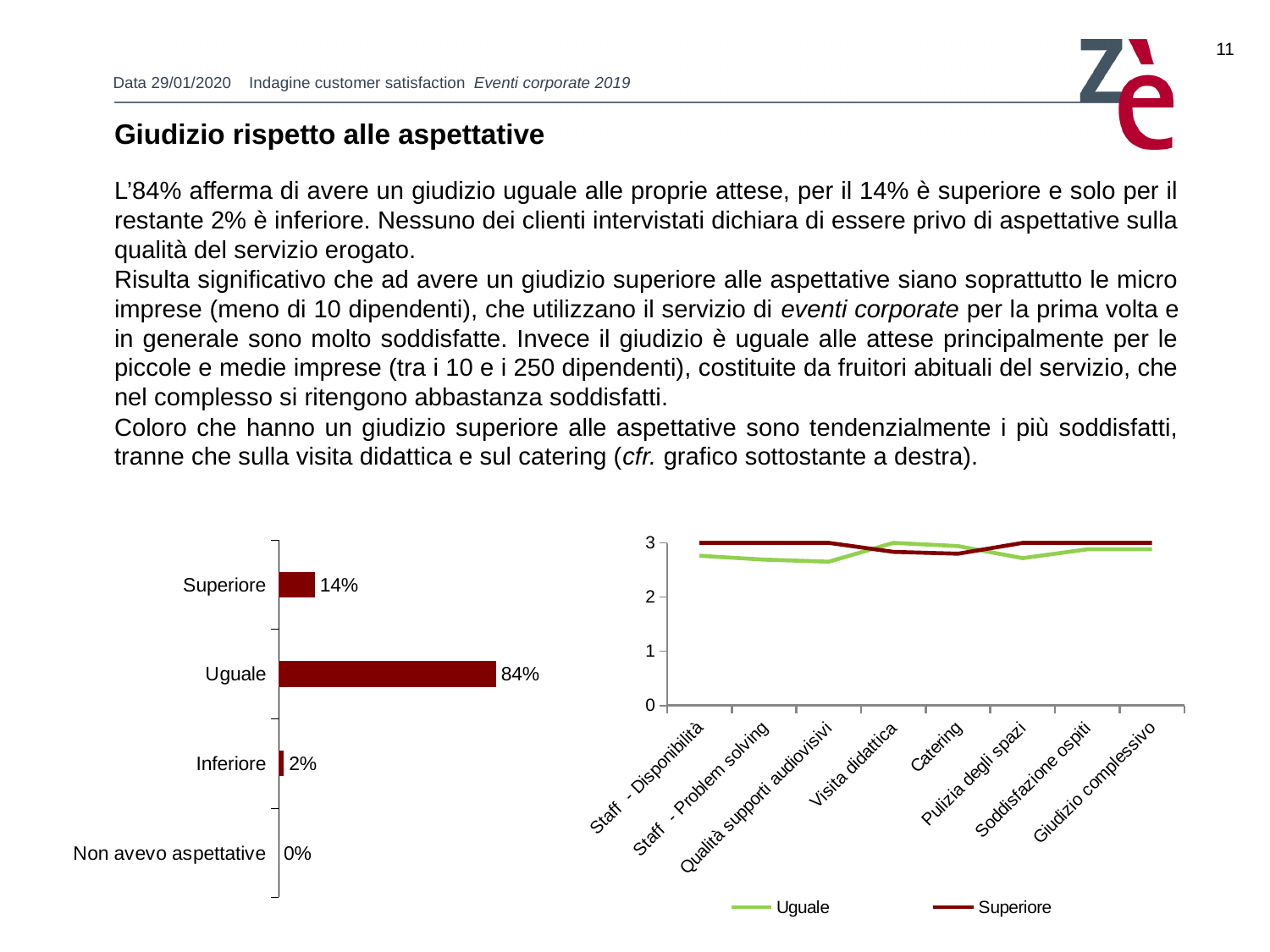
How many categories are shown in the left bar chart? 4 In the right line chart, is the value of the Superiore series for Catering greater or less than 2? greater What kind of chart is the chart on the left of the slide? Bar chart In the left bar chart, what is the value for Inferiore? 2% In the left bar chart, which category has the lowest value? Non avevo aspettative How many series does the legend of the right line chart list? 2 In the left bar chart, what is the value for Superiore? 14% In the left bar chart, which category has the highest value? Uguale In the left bar chart, what is the difference between the values for Uguale and Superiore? 70% In the left bar chart, what is the value for Uguale? 84% In the left bar chart, which is larger, the value for Superiore or the value for Inferiore? Superiore In the right line chart, which series has the higher value for Staff - Disponibilità, Uguale or Superiore? Superiore